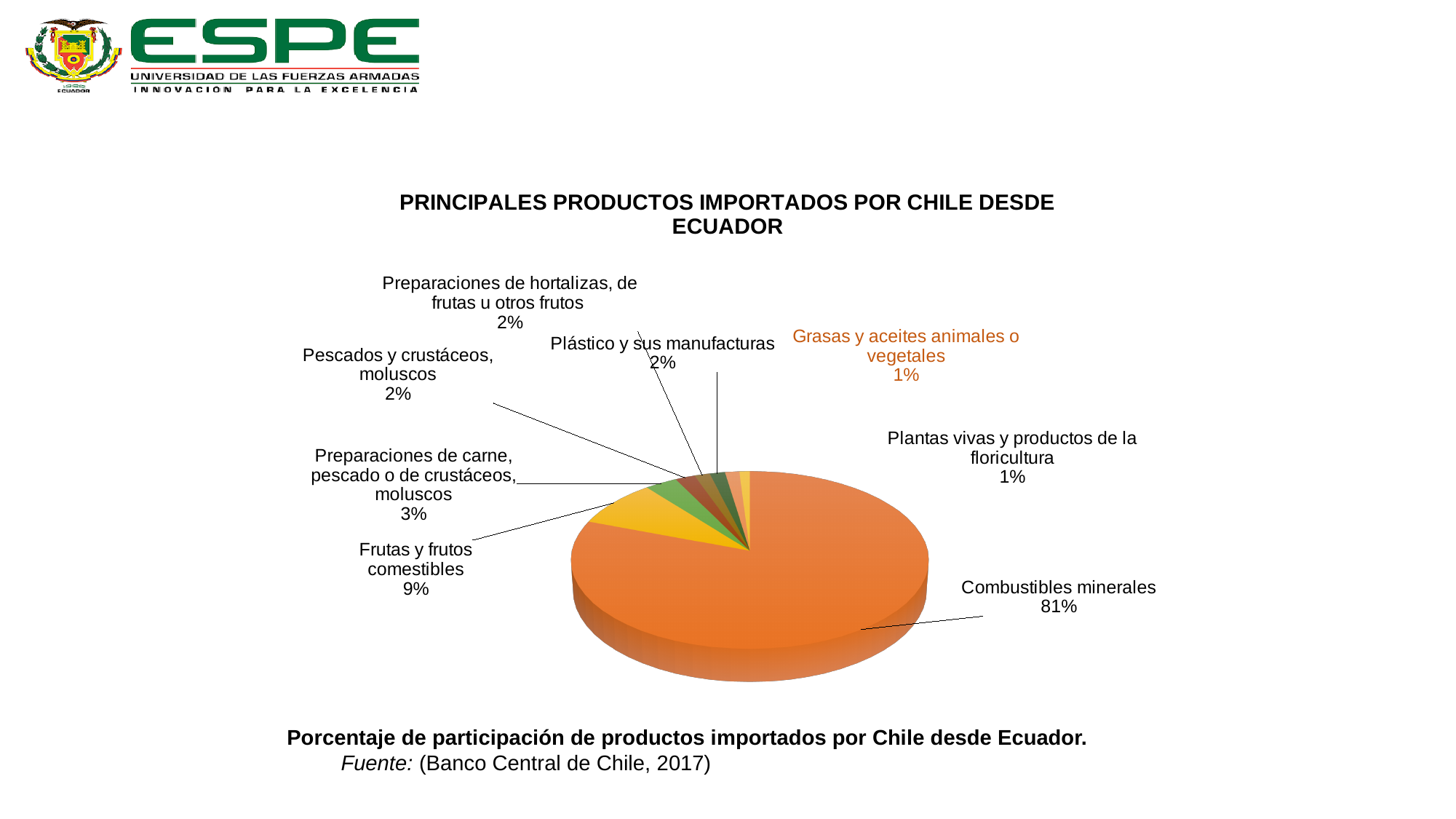
What is the title of the chart? PRINCIPALES PRODUCTOS IMPORTADOS POR CHILE DESDE ECUADOR What percentage is shown for Preparaciones de carne, pescado o de crustáceos, moluscos? 3% What share of the pie does Combustibles minerales represent? 81% What kind of chart is shown on the slide? Pie chart What percentage is shown for Plantas vivas y productos de la floricultura? 1% Which is larger, the share for Frutas y frutos comestibles or the share for Preparaciones de carne, pescado o de crustáceos, moluscos? Frutas y frutos comestibles What percentage is shown for Frutas y frutos comestibles? 9% What percentage is shown for Plástico y sus manufacturas? 2% How many categories are shown in the pie chart? 8 What source is cited below the chart? (Banco Central de Chile, 2017) Which category has the largest share of the pie? Combustibles minerales What is the difference in percentage points between Combustibles minerales and Frutas y frutos comestibles? 72